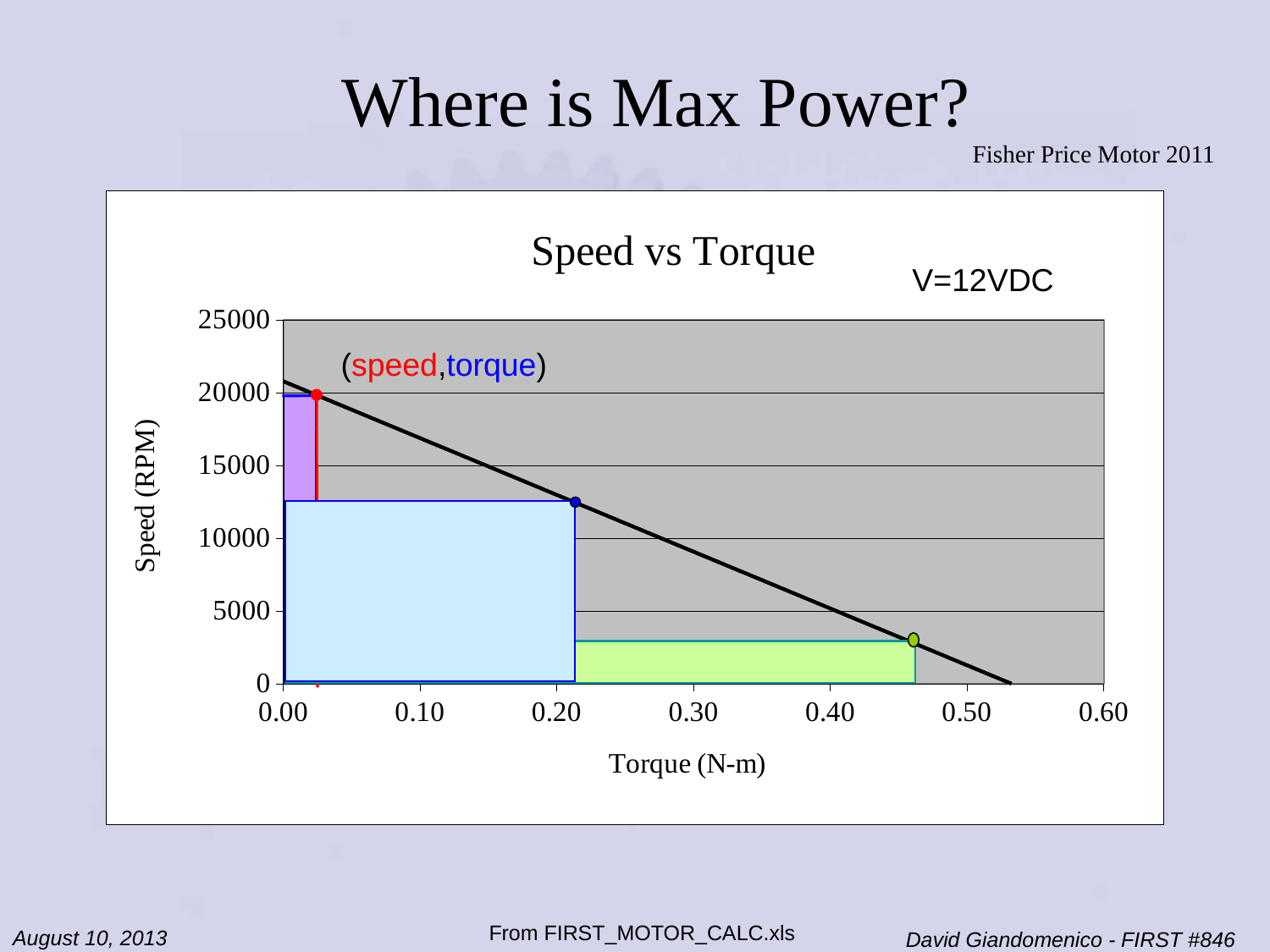
Is the torque at the red marked point greater or less than 0.10 N-m? less How many marked points are shown on the speed-torque line? 3 Is the speed at the green marked point greater or less than 5000 RPM? less What is the label of the y axis? Speed (RPM) Is the torque at the green marked point greater or less than 0.40 N-m? greater As torque increases along the x axis, does speed rise or fall? fall What is the title of the chart? Speed vs Torque Which marked point has the lowest speed: red, blue or green? green Which marked point has the highest speed: red, blue or green? red What type of chart is shown on the slide? line chart